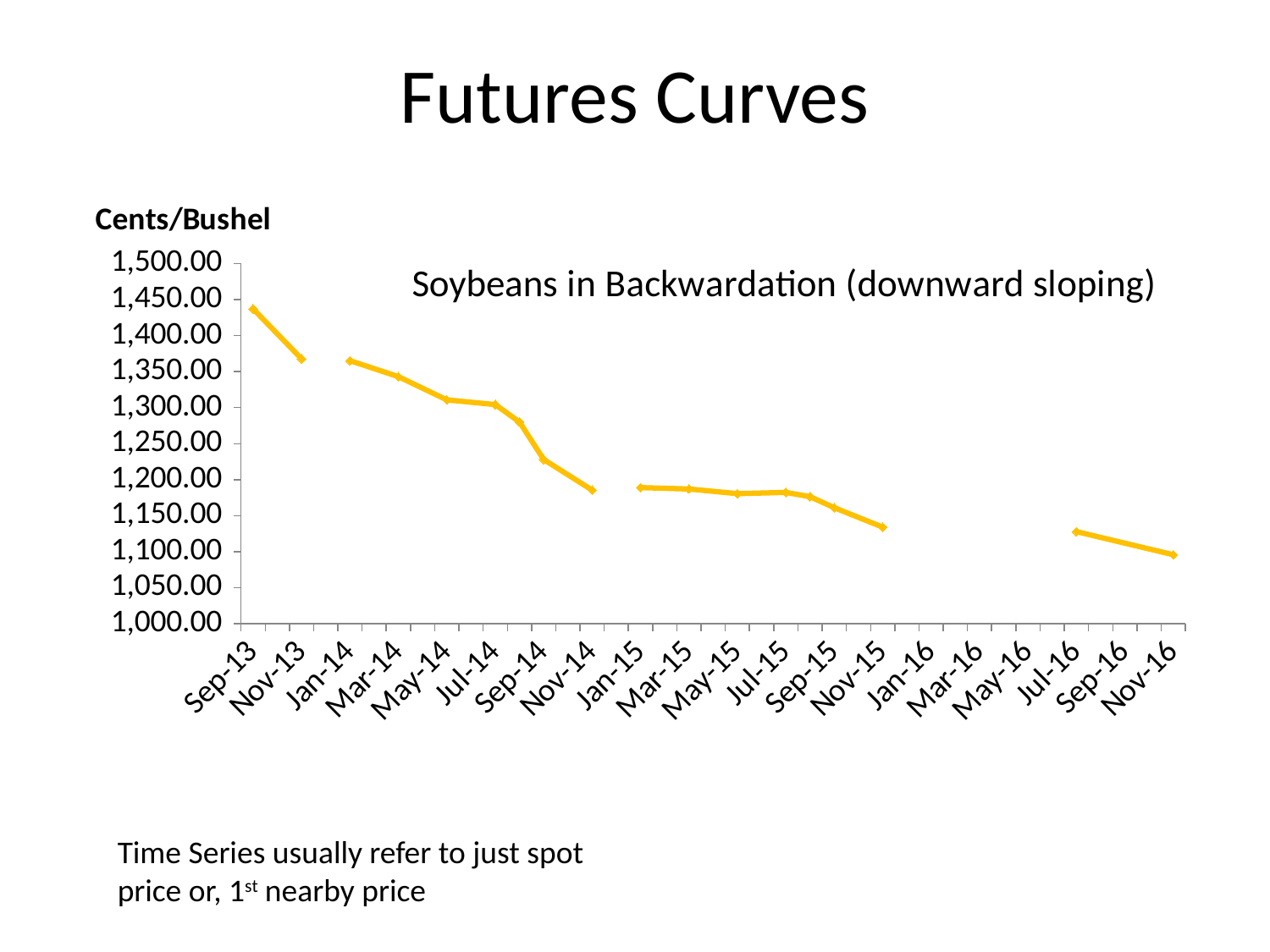
Is the value for Sep-14 greater or less than 1,200.00? greater Which month has the lowest value on the chart? Nov-16 Is the value for Jan-15 greater or less than 1,200.00? less Which is larger, the value for Sep-13 or the value for Nov-13? Sep-13 What kind of chart is shown on the slide? line chart Is the value for Sep-13 greater or less than 1,400.00? greater What unit label is shown above the vertical axis of the chart? Cents/Bushel Do the values generally rise or fall from Sep-13 to Nov-16? fall Which is larger, the value for Mar-14 or the value for Jan-15? Mar-14 Which month has the highest value on the chart? Sep-13